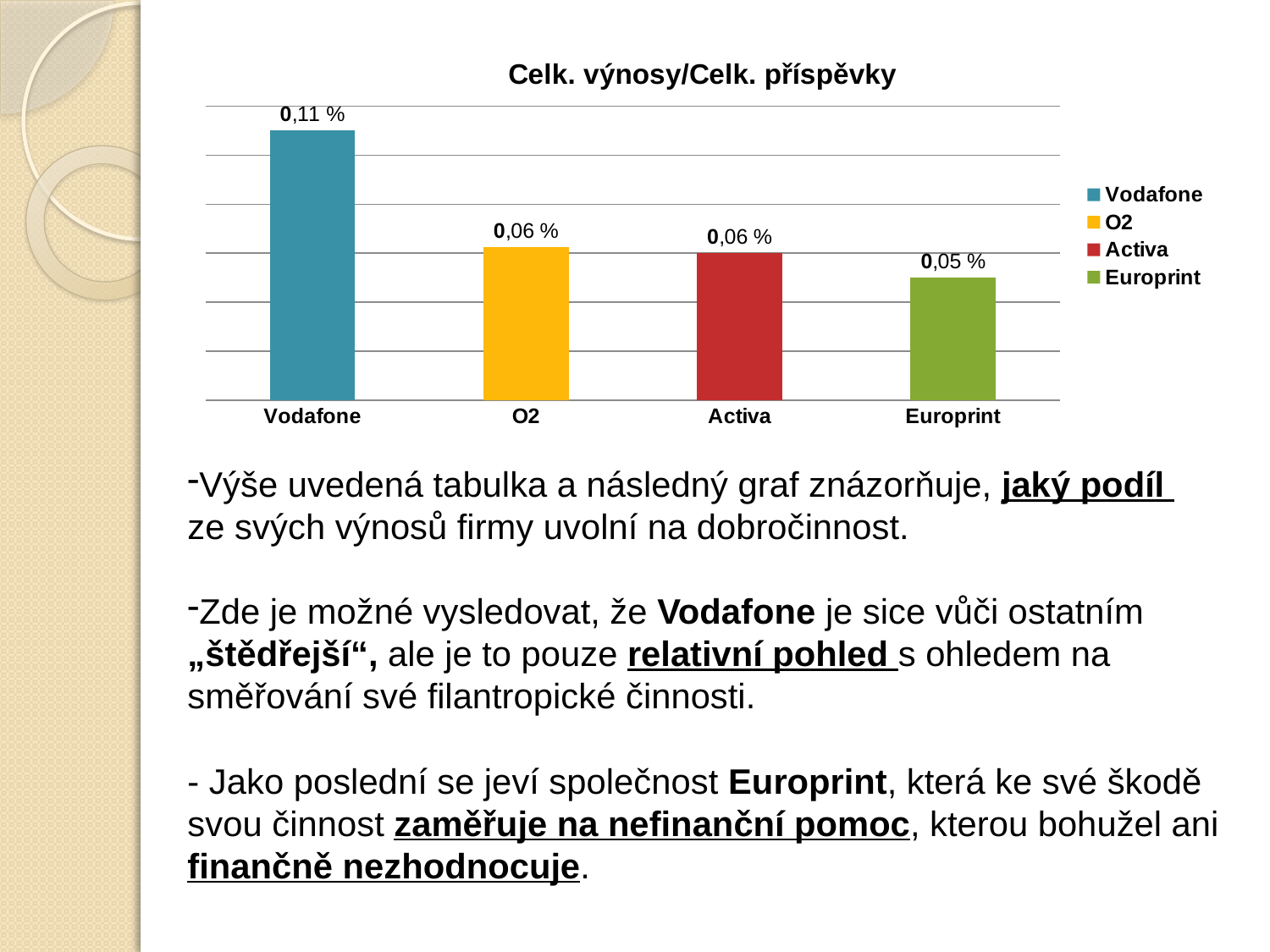
What is the difference between the values for Vodafone and Europrint? 0,06 % What is the difference between the values for Vodafone and O2? 0,05 % Which category has the lowest value? Europrint Which is larger, the value for Vodafone or the value for Activa? Vodafone What is the value for Vodafone? 0,11 % How many entries does the legend list? 4 What is the value for Activa? 0,06 % What is the value for O2? 0,06 % Which category has the highest value? Vodafone What is the value for Europrint? 0,05 % What kind of chart is shown on the slide? bar chart How many categories are shown on the x axis? 4